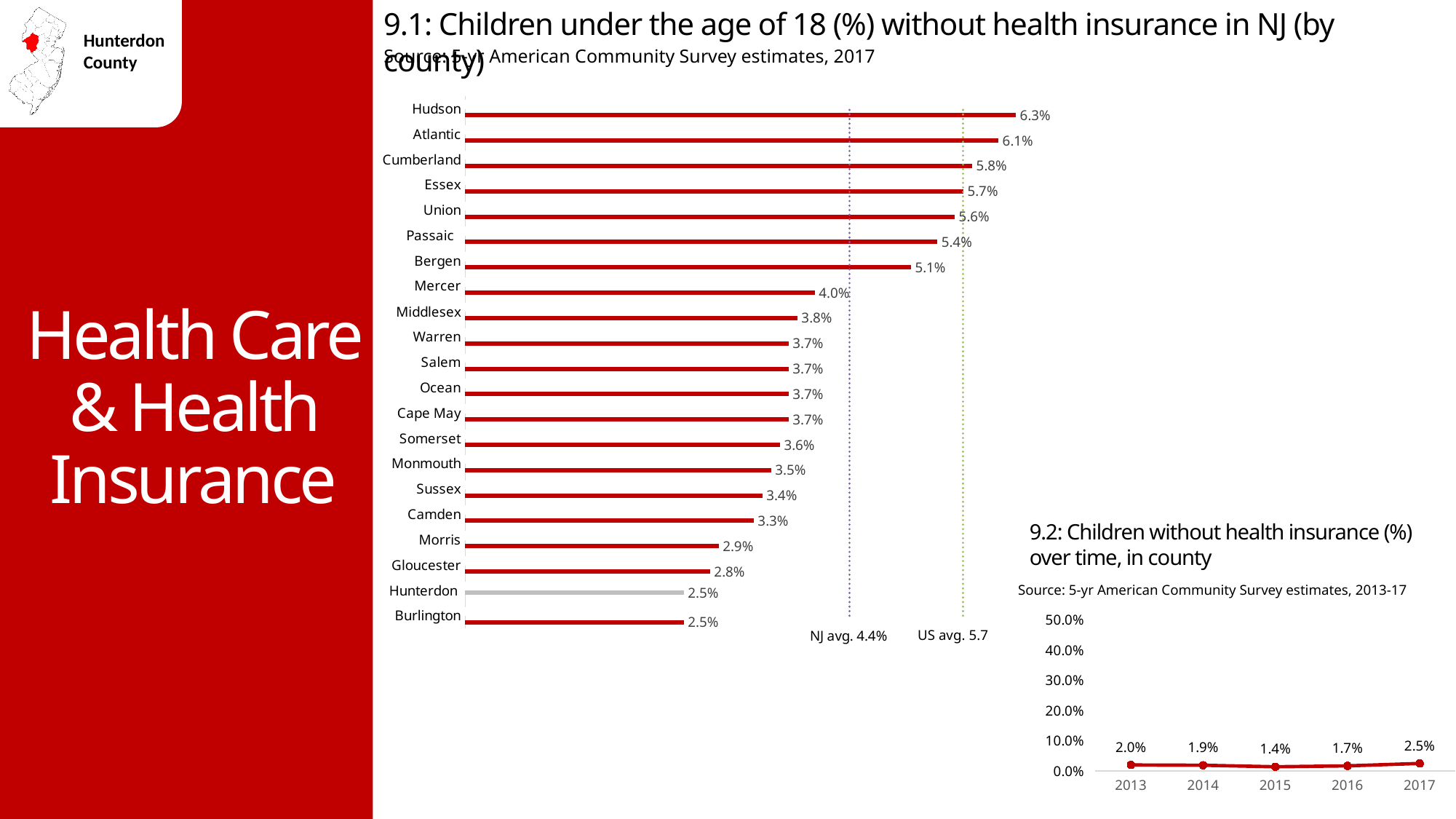
In chart 9.1, which county has the highest percentage of children without health insurance? Hudson In chart 9.1, how many counties are plotted? 21 In chart 9.2, what was the percentage of children without health insurance in the county in 2015? 1.4% In chart 9.1, what percentage of children under 18 in Hudson County are without health insurance? 6.3% In chart 9.1, what NJ average value is marked by the dotted line? 4.4% In chart 9.2, how many years are plotted? 5 In chart 9.1, what is the difference between the values for Hudson and Hunterdon? 3.8% In chart 9.2, what is the difference between the 2017 and 2013 values? 0.5% In chart 9.2, which year has the highest value? 2017 In chart 9.1, what is the value shown for Hunterdon County? 2.5% What kind of chart is chart 9.1? Bar chart In chart 9.1, which county has a higher value, Bergen or Mercer? Bergen